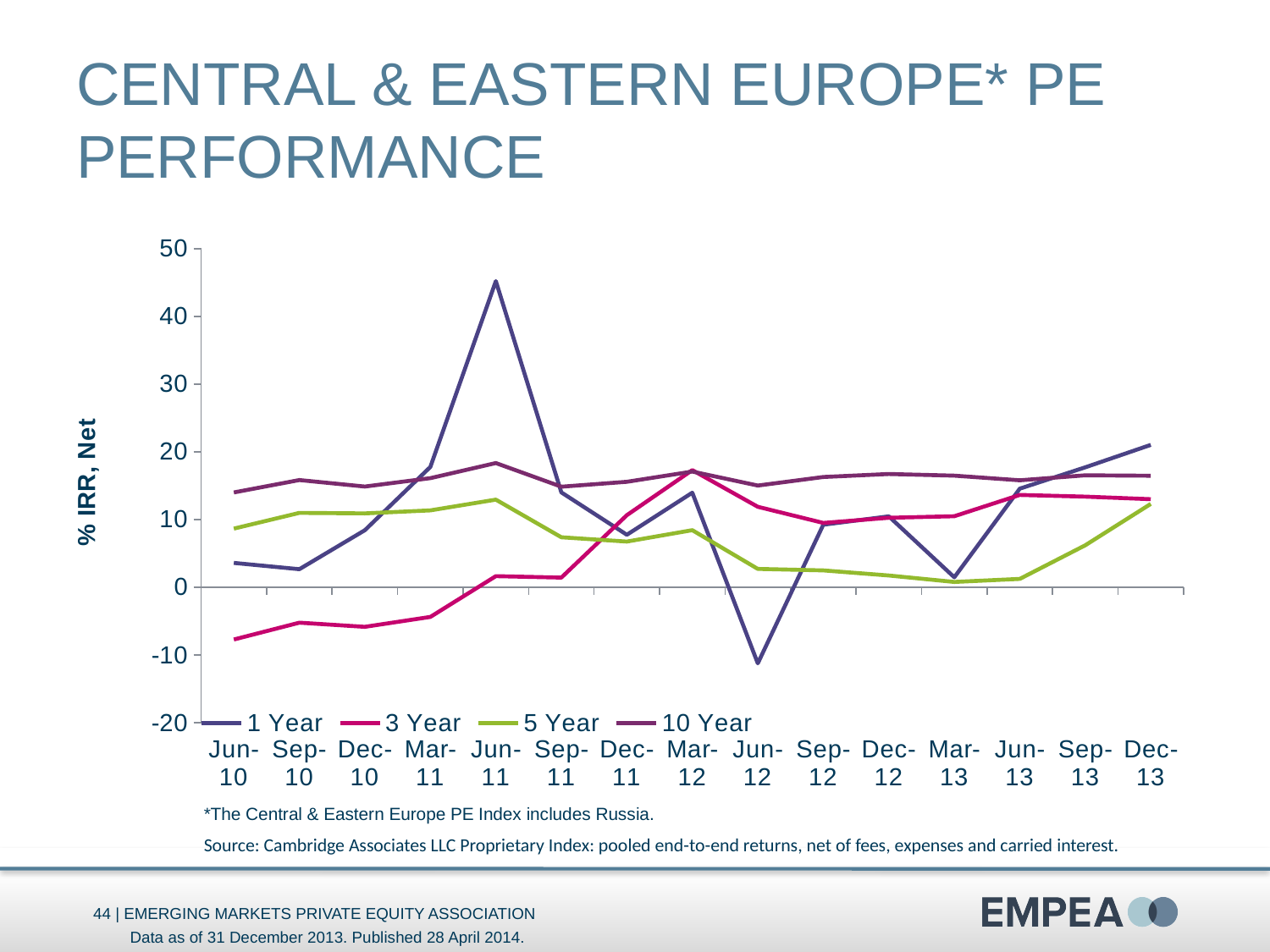
How many time periods are plotted along the x axis? 15 At Jun-12, which series has the larger value, 1 Year or 10 Year? 10 Year Is the value for the 3 Year series at Jun-10 greater or less than 0? less In which period does the 1 Year series reach its highest value? Jun-11 What kind of chart is shown on the slide? line chart Does the 3 Year series rise or fall from Jun-10 to Mar-12? rise Is the value for the 10 Year series at Dec-13 greater or less than 10? greater Is the value for the 5 Year series at Mar-13 greater or less than 10? less In which period does the 1 Year series reach its lowest value? Jun-12 What is the label on the y axis? % IRR, Net How many series does the legend list? 4